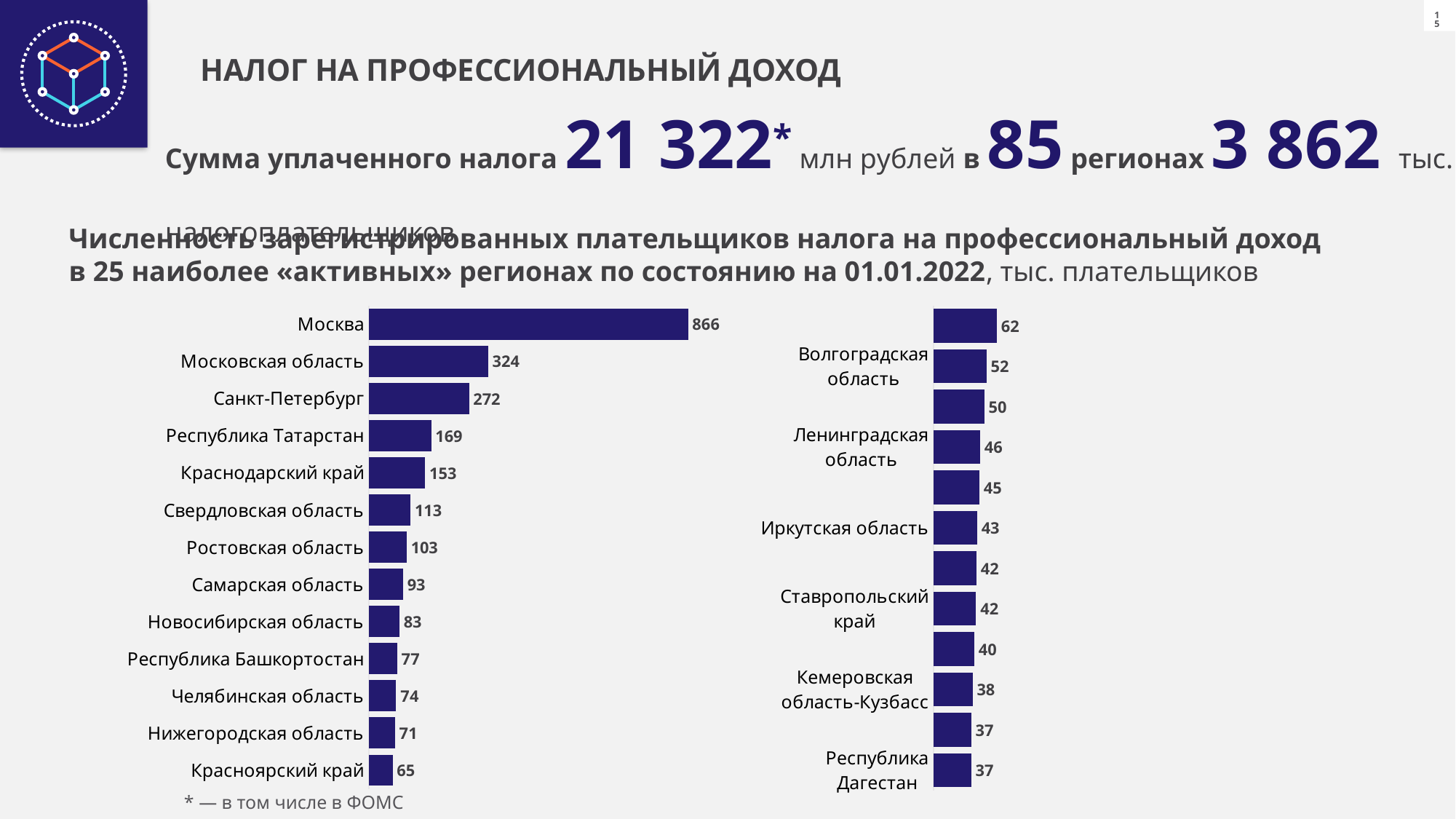
On the left chart, which is larger: the value for Республика Татарстан or Краснодарский край? Республика Татарстан What type of chart is used on the slide? Bar chart On the right chart, what is the difference between the values for Ленинградская область and Республика Дагестан? 9 On the left chart, what is the difference between the values for Москва and Московская область? 542 On the left chart, which region has the lowest value? Красноярский край On the left chart, what is the value for Санкт-Петербург? 272 On the left chart, which region has the highest value? Москва On the right chart, what is the value for Иркутская область? 43 On the left chart, how many regions are shown? 13 On the left chart, what is the value for Москва? 866 On the right chart, what is the value for Волгоградская область? 52 On the left chart, what is the value for Свердловская область? 113